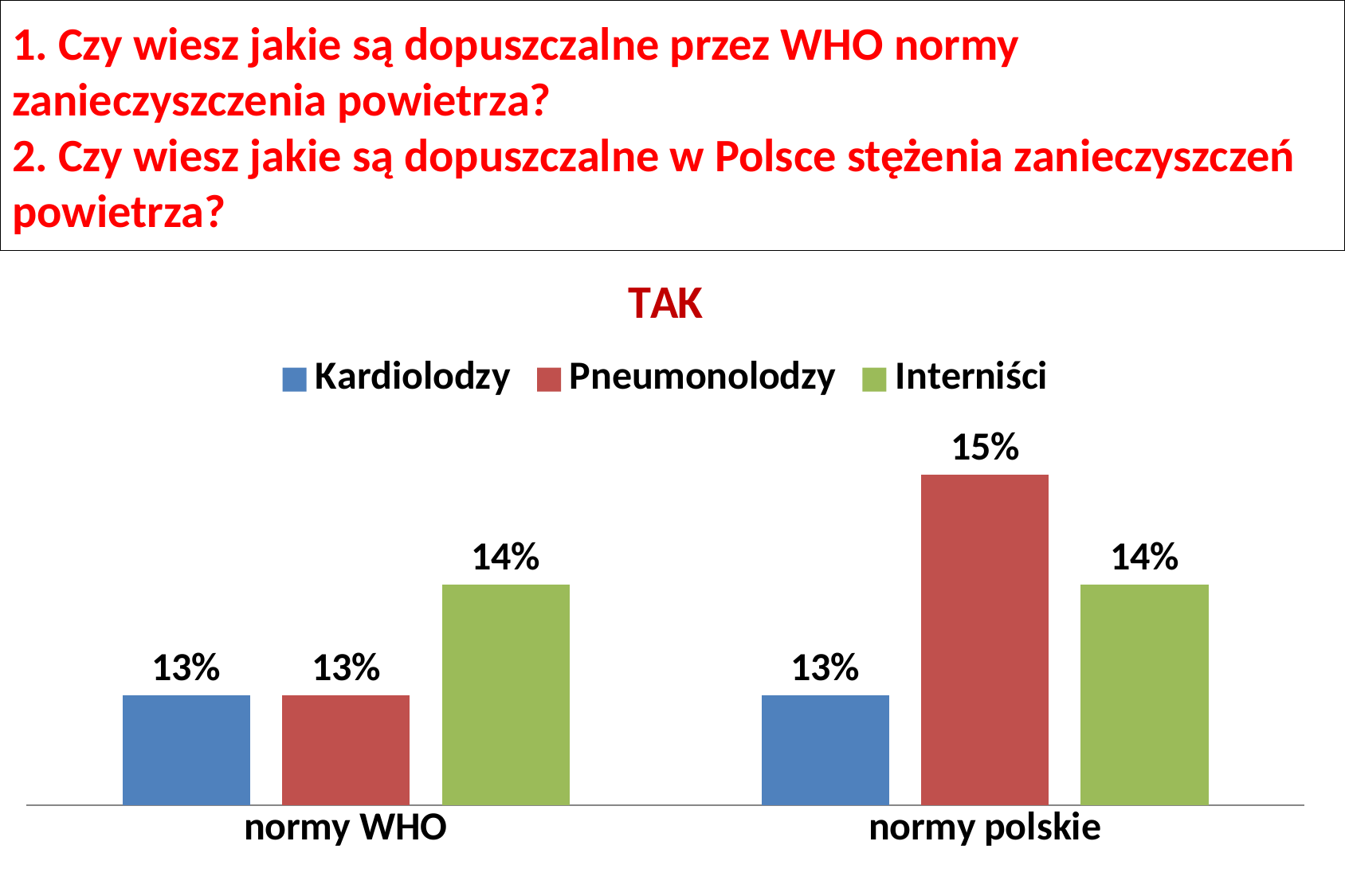
What is the difference between the Pneumonolodzy values for normy polskie and normy WHO? 2% What is the title of the chart? TAK What is the value for Interniści in the normy polskie category? 14% How many series does the legend list? 3 Which is larger: the Pneumonolodzy value for normy polskie or the Interniści value for normy polskie? Pneumonolodzy value for normy polskie Which series has the highest value in the normy polskie category? Pneumonolodzy What is the value for Interniści in the normy WHO category? 14% What kind of chart is shown on the slide? Bar chart What is the value for Pneumonolodzy in the normy polskie category? 15% How many categories are shown on the x axis? 2 Which series has the highest value in the normy WHO category? Interniści What is the value for Kardiolodzy in the normy WHO category? 13%